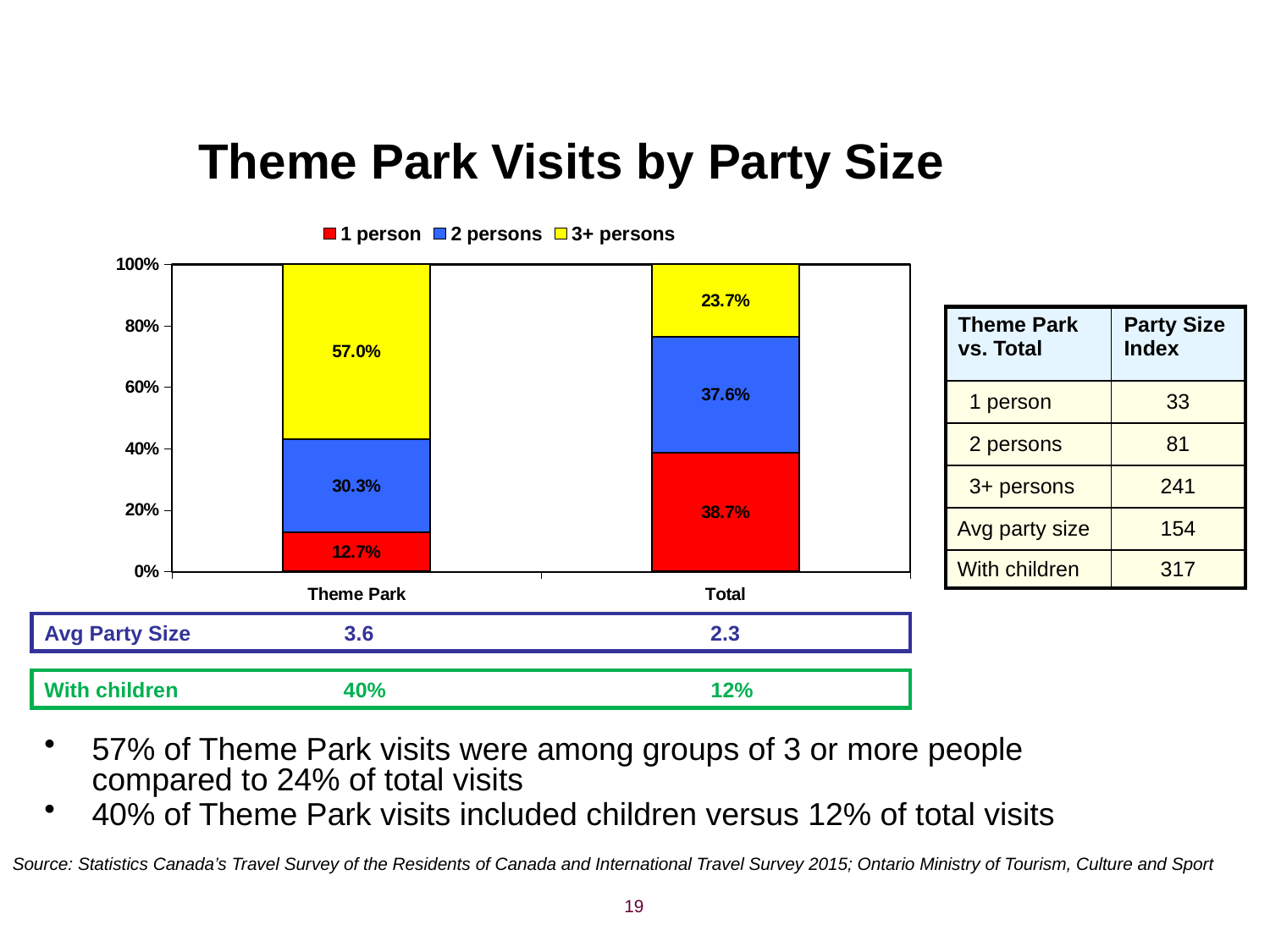
How many categories are shown on the x axis? 2 What is the difference between the 3+ persons share for Theme Park and for Total? 33.3% How many series does the legend list? 3 Which party size has the largest share of Theme Park visits? 3+ persons Which party size has the smallest share of Theme Park visits? 1 person What percentage of Total visits were by parties of 3+ persons? 23.7% What colour represents the 2 persons series in the chart? Blue What percentage of Theme Park visits were by 2 persons? 30.3% What kind of chart is shown on the slide? Stacked bar chart What percentage of Theme Park visits were by parties of 3+ persons? 57.0% Which is larger: the 1 person share for Theme Park or for Total? Total What percentage of Total visits were by 1 person? 38.7%